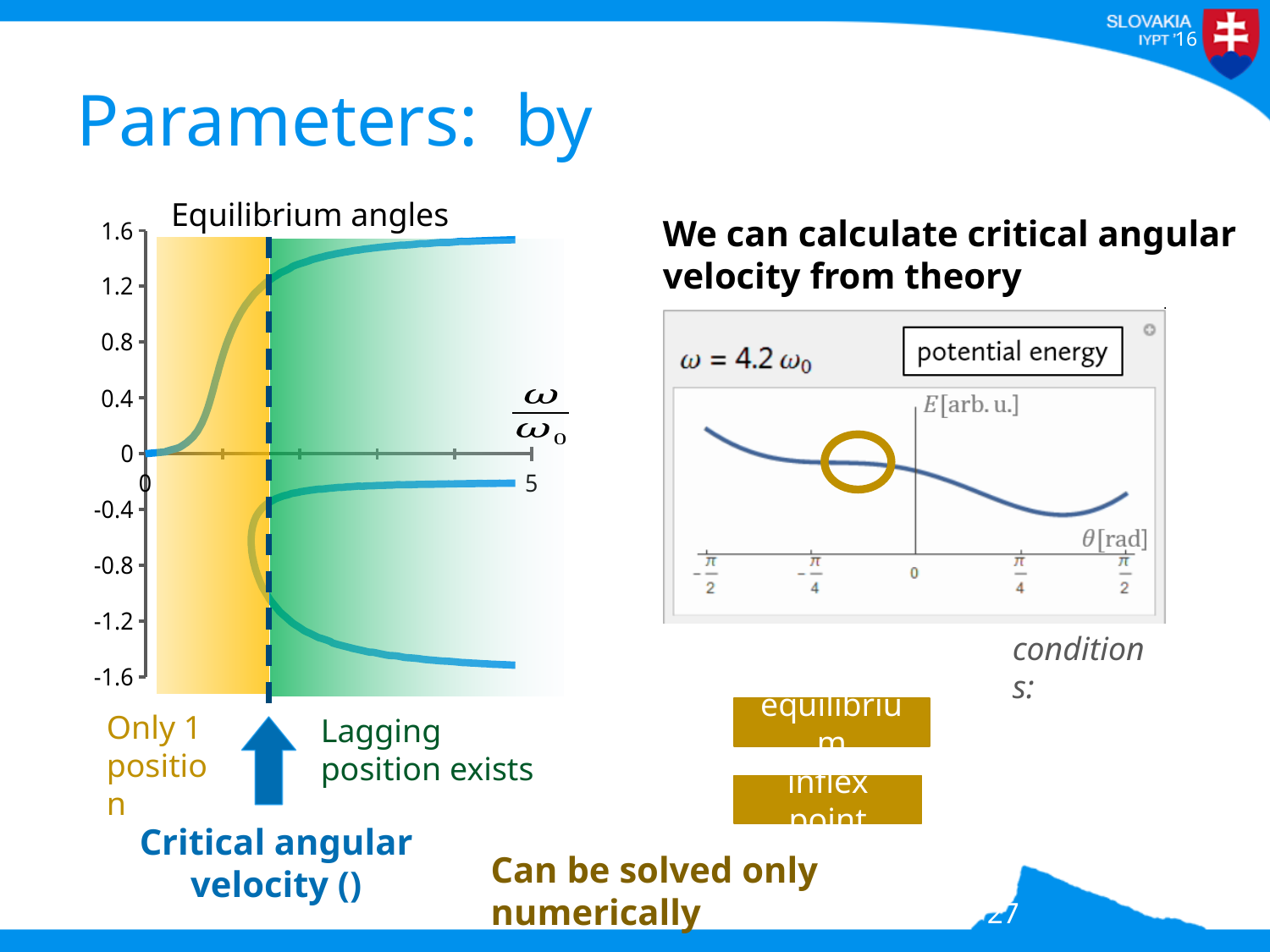
In the 'Equilibrium angles' chart, is the value of the lowest curve at ω/ω0 = 5 greater or less than -1.2? less What is the title of the chart on the left of the slide? Equilibrium angles In the 'Equilibrium angles' chart, is the value of the upper curve at ω/ω0 = 5 greater or less than 1.2? greater In the 'Equilibrium angles' chart, what is the highest value labelled on the vertical axis? 1.6 What kind of chart is the 'Equilibrium angles' chart on the left of the slide? line chart What is the title shown in the box above the chart on the right of the slide? potential energy In the 'Equilibrium angles' chart, does the upper curve rise or fall as ω/ω0 increases from 0 to 5? rises In the 'Equilibrium angles' chart, what is the lowest value labelled on the vertical axis? -1.6 In the 'potential energy' chart on the right, how many tick labels are shown on the horizontal θ axis? 5 In the 'potential energy' chart on the right, what is the largest tick label on the horizontal θ axis? π/2 In the 'Equilibrium angles' chart, what is the largest value labelled on the horizontal axis? 5 In the 'potential energy' chart on the right, what value of ω is stated above the plot? ω = 4.2 ω0